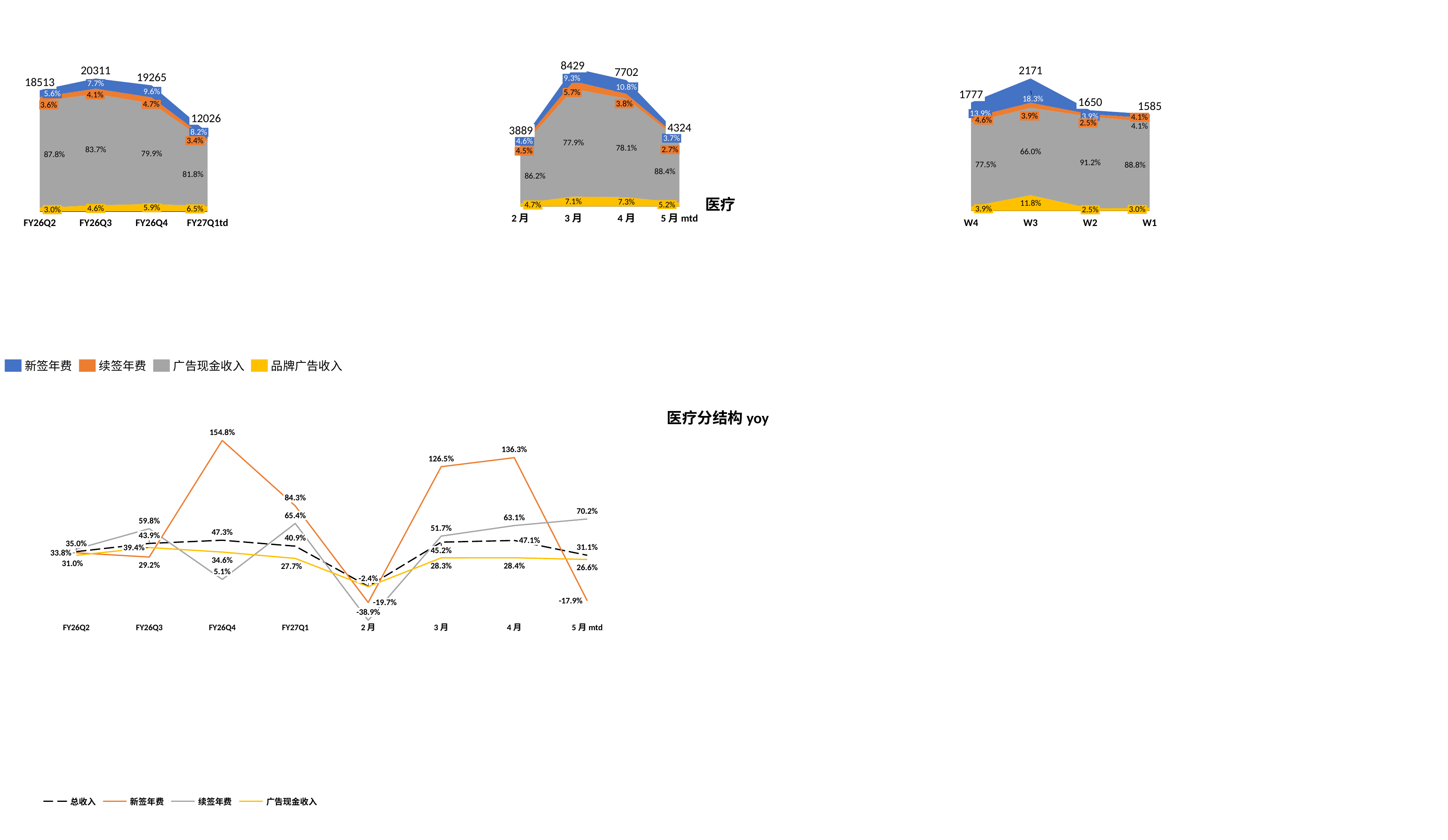
In the top-right chart, what share does 品牌广告收入 have in W3? 11.8% In the top-left chart, what share does 广告现金收入 have in FY26Q2? 87.8% How many series does the legend of the top stacked charts list? 4 In the top-middle chart, what share does 新签年费 have in 4月? 10.8% In the top-left chart, which period has the lowest total value? FY27Q1td In the top-left chart, what is the total value shown for FY26Q3? 20311 In the top-right chart, which week has the highest total value? W3 In the top-middle chart, what is the difference between the totals for 3月 and 4月? 727 In the top-middle chart, what is the total value for 3月? 8429 What kind of chart is the bottom chart titled 医疗分结构 yoy? Line chart In the bottom chart titled 医疗分结构 yoy, what is the highest value of the 新签年费 line and at which period? 154.8% at FY26Q4 In the bottom chart titled 医疗分结构 yoy, what is the 总收入 value for FY26Q4? 47.3%